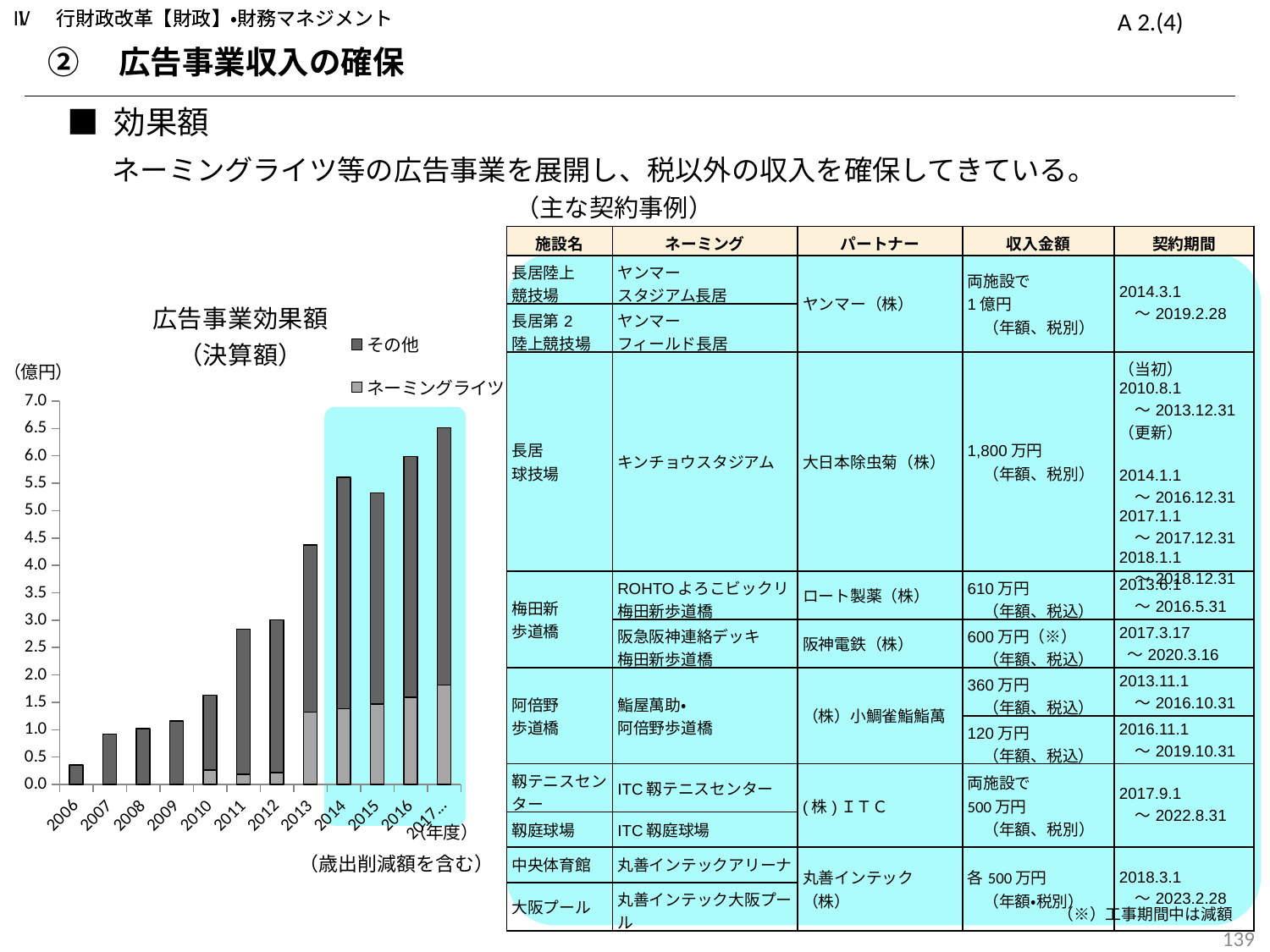
Which fiscal year has the lowest total bar in the chart? 2006 Do the total bar values generally rise or fall from 2006 to 2017? rise What is the title of the chart? 広告事業効果額（決算額） Is the total value for 2013 greater or less than 4.0? greater What kind of chart is shown on the slide? stacked bar chart Which fiscal year has the larger total bar, 2013 or 2014? 2014 Is the total value for 2017 greater or less than 6.0? greater How many series does the chart legend list? 2 Which fiscal year has the highest total bar in the chart? 2017 How many fiscal years are plotted on the x axis of the chart? 12 What unit is shown on the vertical axis of the chart? 億円 Is the total value for 2006 greater or less than 0.5? less